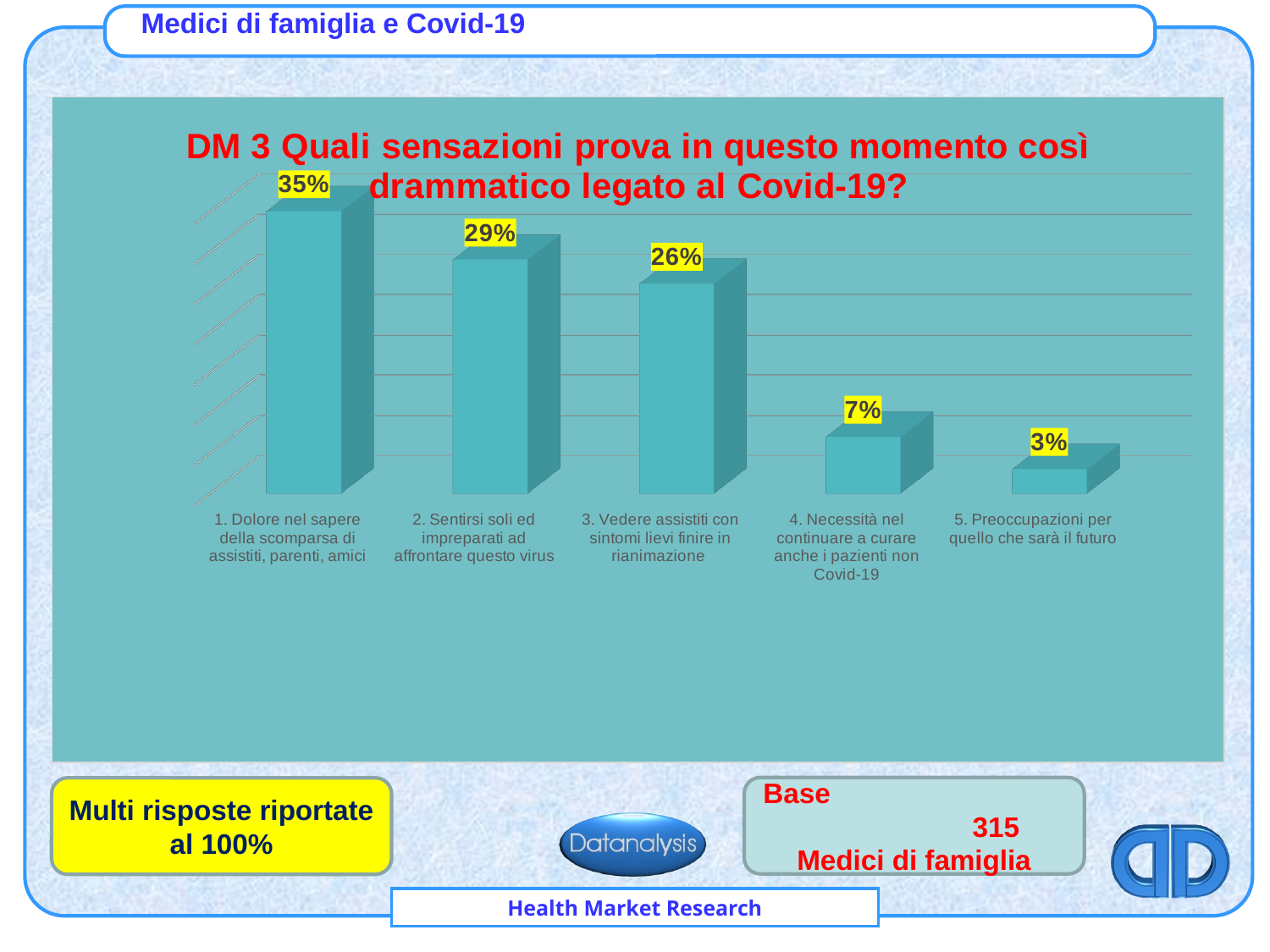
What is the value for "1. Dolore nel sapere della scomparsa di assistiti, parenti, amici"? 35% What is the difference between the values for "4. Necessità nel continuare a curare anche i pazienti non Covid-19" and "5. Preoccupazioni per quello che sarà il futuro"? 4% What kind of chart is shown on the slide? Bar chart Do the values rise or fall from left to right across the categories? Fall What is the value for "3. Vedere assistiti con sintomi lievi finire in rianimazione"? 26% What is the difference between the values for "1. Dolore nel sapere della scomparsa di assistiti, parenti, amici" and "2. Sentirsi soli ed impreparati ad affrontare questo virus"? 6% Which category has the highest value? 1. Dolore nel sapere della scomparsa di assistiti, parenti, amici What is the value for "5. Preoccupazioni per quello che sarà il futuro"? 3% Which category has the lowest value? 5. Preoccupazioni per quello che sarà il futuro How many categories are shown in the chart? 5 What is the value for "2. Sentirsi soli ed impreparati ad affrontare questo virus"? 29% Which is larger, the value for "3. Vedere assistiti con sintomi lievi finire in rianimazione" or the value for "4. Necessità nel continuare a curare anche i pazienti non Covid-19"? 3. Vedere assistiti con sintomi lievi finire in rianimazione